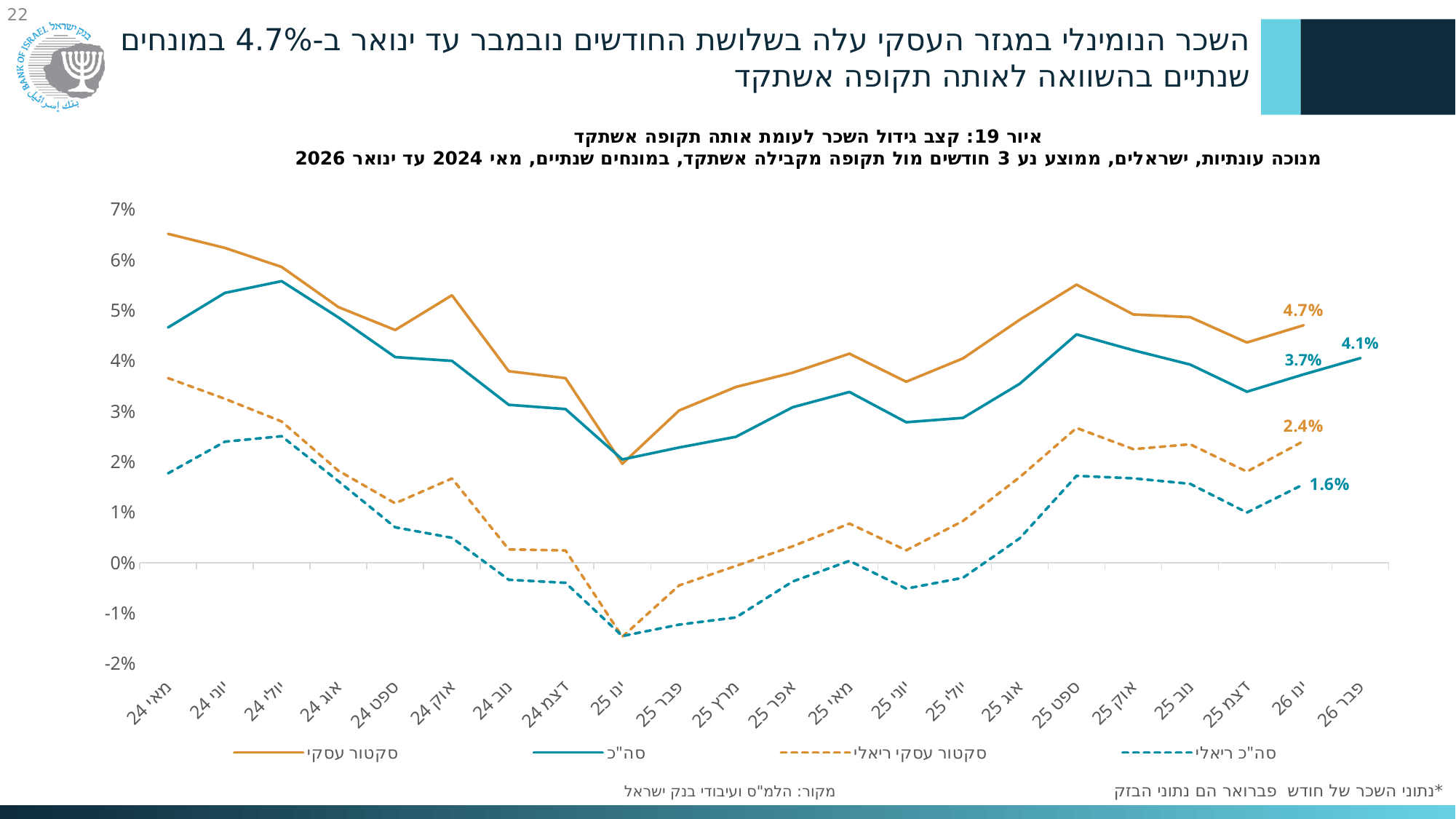
What is the value of סה"כ at פבר 26? 4.1% How many series does the legend list? 4 What is the value of סקטור עסקי at ינו 26? 4.7% What is the value of סקטור עסקי ריאלי at ינו 26? 2.4% Is the value for סה"כ ריאלי at ינו 25 greater or less than -1%? less What is the value of סה"כ at ינו 26? 3.7% What kind of chart is shown on the slide? line chart Is the value for סקטור עסקי at מאי 24 greater or less than 6%? greater How many months are shown on the x axis? 22 At ינו 26, which is larger: סקטור עסקי or סקטור עסקי ריאלי? סקטור עסקי At ינו 26, what is the difference between סקטור עסקי and סה"כ? 1.0 percentage points